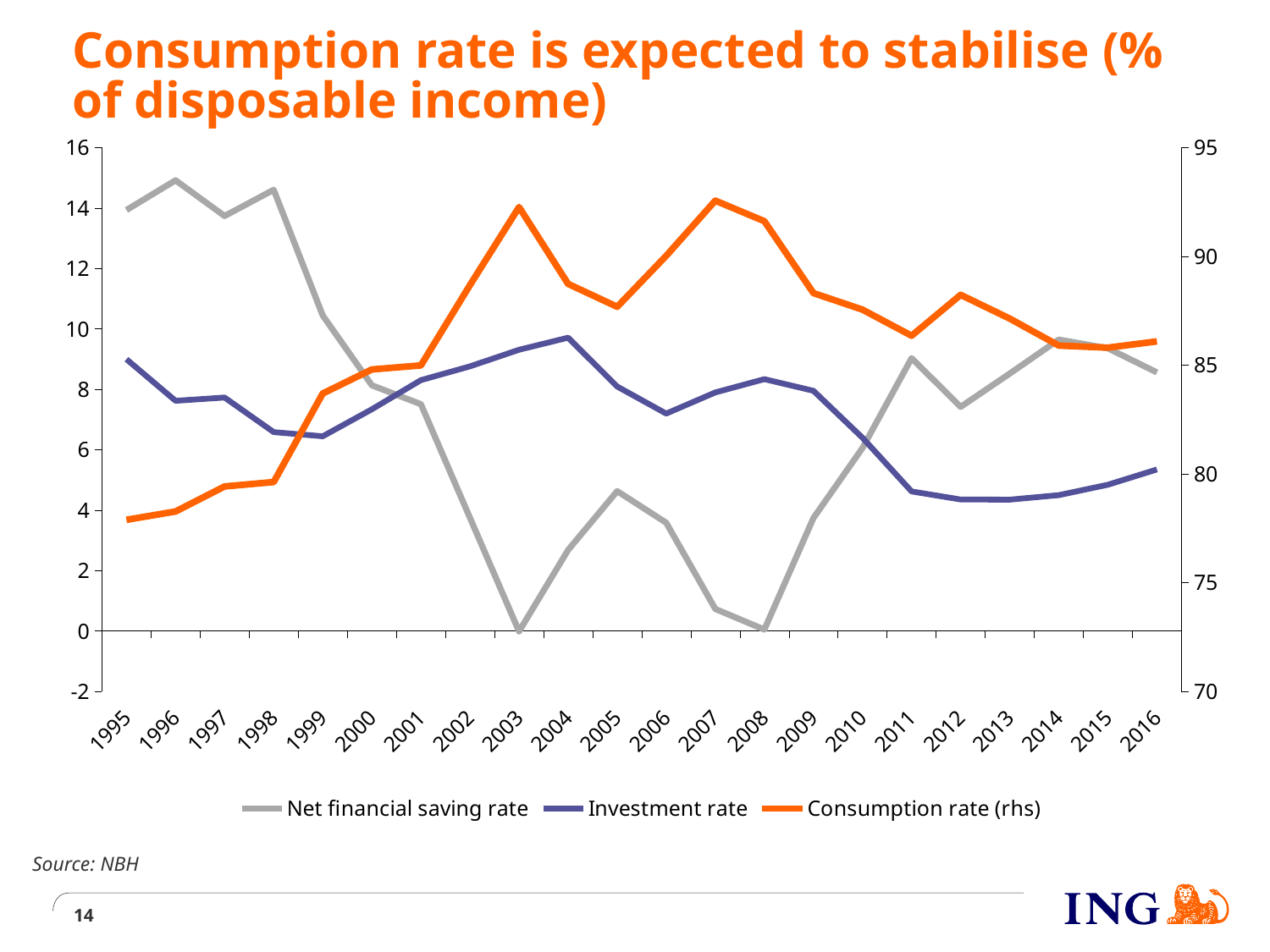
Does the Investment rate rise or fall between 2004 and 2012? Fall What colour is the Consumption rate (rhs) line? Orange Is the Net financial saving rate in 1996 greater or less than 14? greater How many series does the legend list? 3 In which year is the Net financial saving rate highest? 1996 In which year is the Consumption rate (rhs) lowest? 1995 Which is larger, the Net financial saving rate in 1996 or in 2016? 1996 Is the Consumption rate (rhs) in 2016 greater or less than 85? greater What kind of chart is shown on the slide? Line chart Which series is plotted against the right-hand axis? Consumption rate (rhs) In which year is the Investment rate highest? 2004 How many years are shown on the x axis? 22